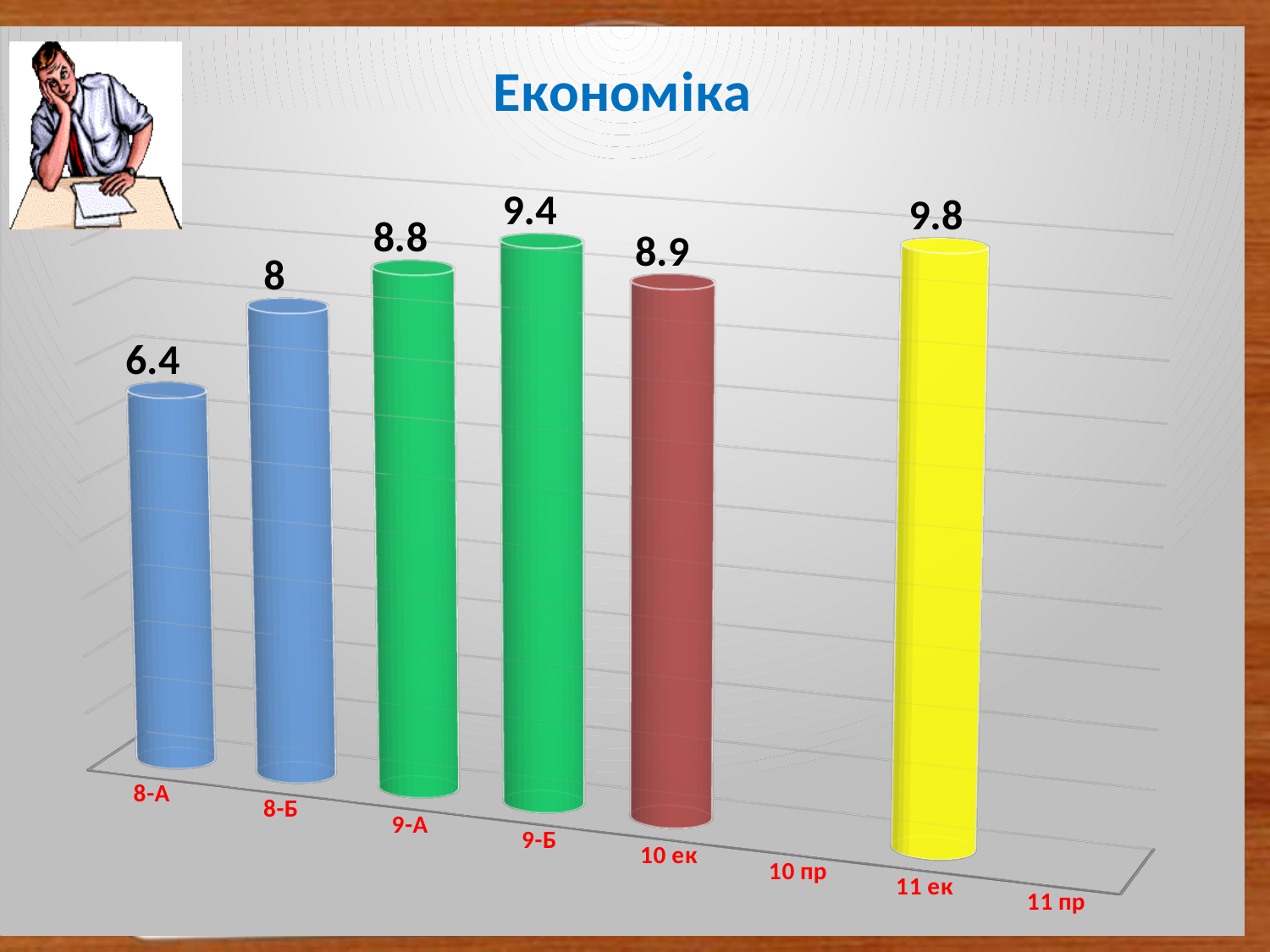
What is the title of the chart? Економіка What is the difference between the values for 9-А and 8-Б? 0.8 Which is larger, the value for 9-Б or the value for 10 ек? 9-Б What is the difference between the values for 11 ек and 8-А? 3.4 What is the value for 9-Б? 9.4 What is the value for 8-А? 6.4 How many bars are plotted on the chart? 6 What kind of chart is shown on the slide? bar chart What is the value for 10 ек? 8.9 What is the value for 11 ек? 9.8 Which category has the highest value? 11 ек Which category has the lowest value among the plotted bars? 8-А